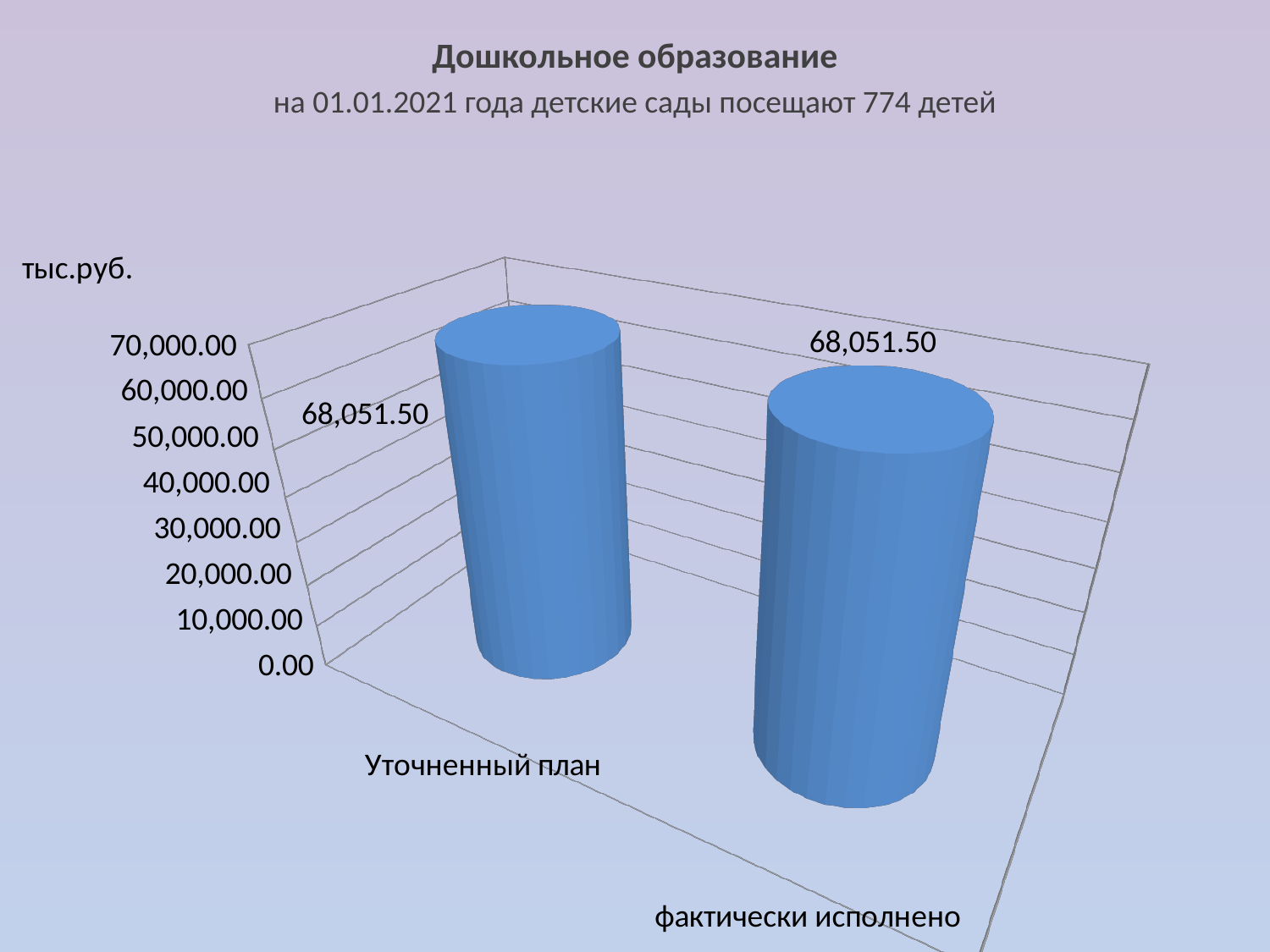
Is the value for фактически исполнено larger than, smaller than, or equal to the value for Уточненный план? equal What kind of chart is shown on the slide? bar chart Is the value for Уточненный план greater or less than 60,000.00? greater What is the difference between the values for Уточненный план and фактически исполнено? 0.00 How many categories are plotted on the chart? 2 What is the value for Уточненный план? 68,051.50 What unit is shown on the value axis of the chart? тыс.руб. What is the value for фактически исполнено? 68,051.50 Is the value for фактически исполнено greater or less than 70,000.00? less